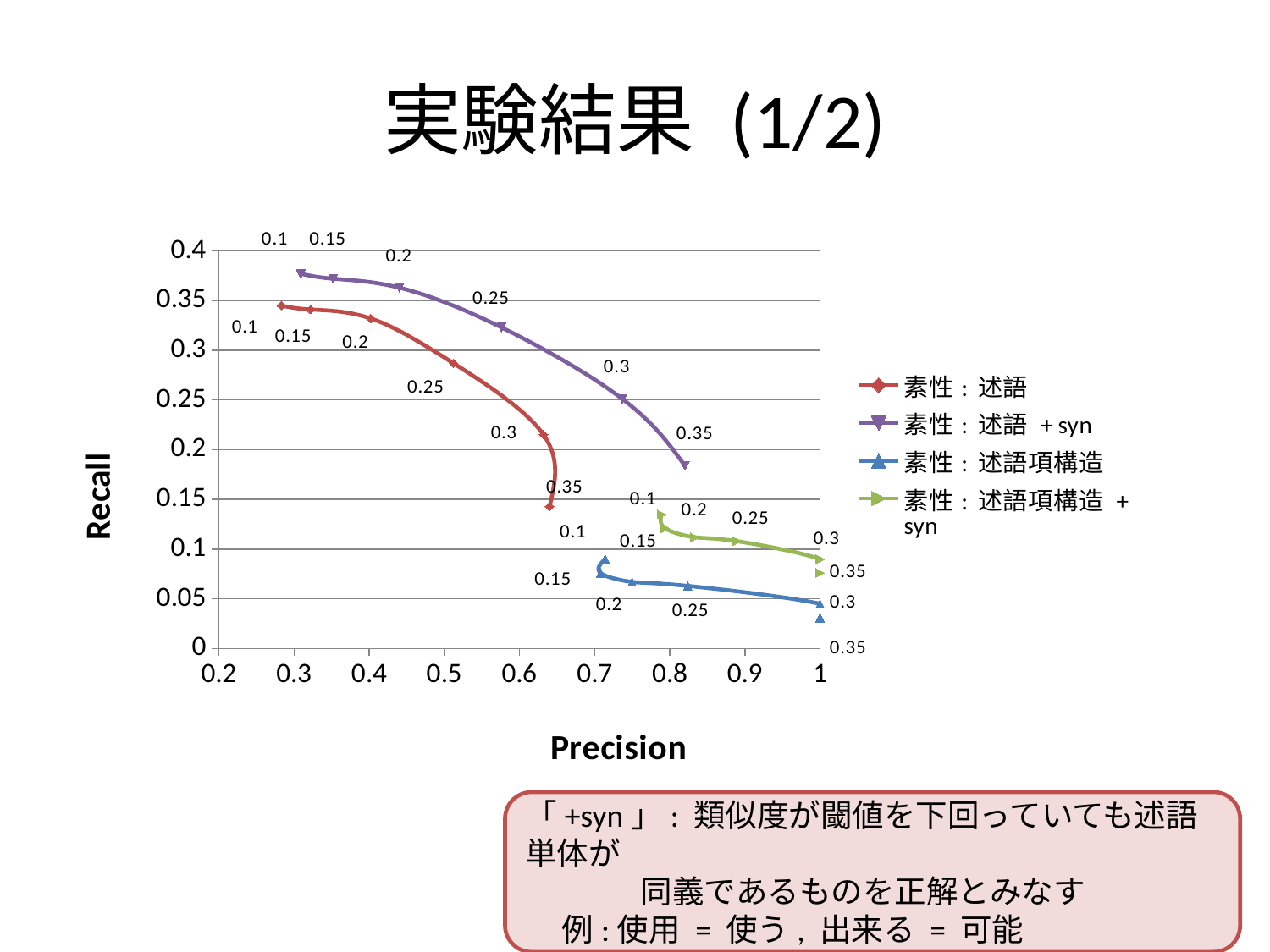
Is the recall of the 素性：述語項構造 +syn series at precision 1 greater or less than 0.1? less Which series has the lowest recall values on the chart? 素性：述語項構造 What is the title of the vertical axis of the chart? Recall Which series has higher recall at the point labelled 0.3: 素性：述語 or 素性：述語 +syn? 素性：述語 +syn Is the recall of the 素性：述語 +syn series at the point labelled 0.35 greater or less than 0.15? greater Is the highest recall of the 素性：述語 +syn series greater or less than 0.35? greater How many series does the chart legend list? 4 How many data points are plotted for the 素性：述語項構造 series? 6 What is the title of the horizontal axis of the chart? Precision Which series reaches the highest recall on the chart? 素性：述語 +syn As precision increases along the x axis, does recall for the 素性：述語 series rise or fall? fall